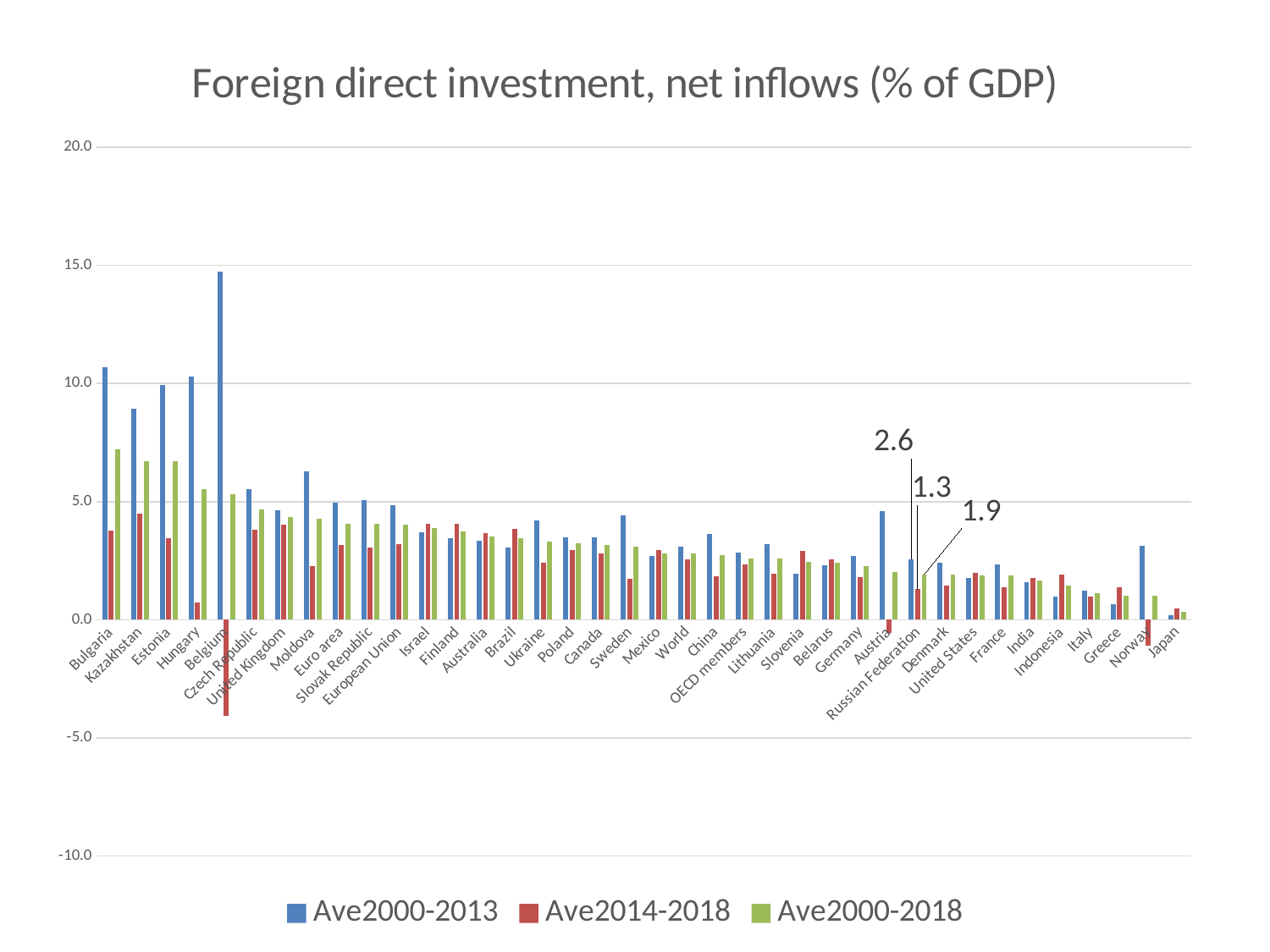
Which has the larger Ave2000-2013 value, Bulgaria or Kazakhstan? Bulgaria Is the Ave2000-2013 value for Bulgaria greater or less than 10.0? greater Which category has the highest Ave2000-2013 value? Belgium What is the difference between the Ave2000-2013 and Ave2014-2018 values for the Russian Federation? 1.3 What is the Ave2014-2018 value for the Russian Federation? 1.3 What is the Ave2000-2018 value for the Russian Federation? 1.9 What is the Ave2000-2013 value for the Russian Federation? 2.6 How many categories are shown on the x axis? 38 Which category has the lowest Ave2014-2018 value? Belgium What is the title of the chart? Foreign direct investment, net inflows (% of GDP) How many series does the legend list? 3 What type of chart is shown on the slide? bar chart